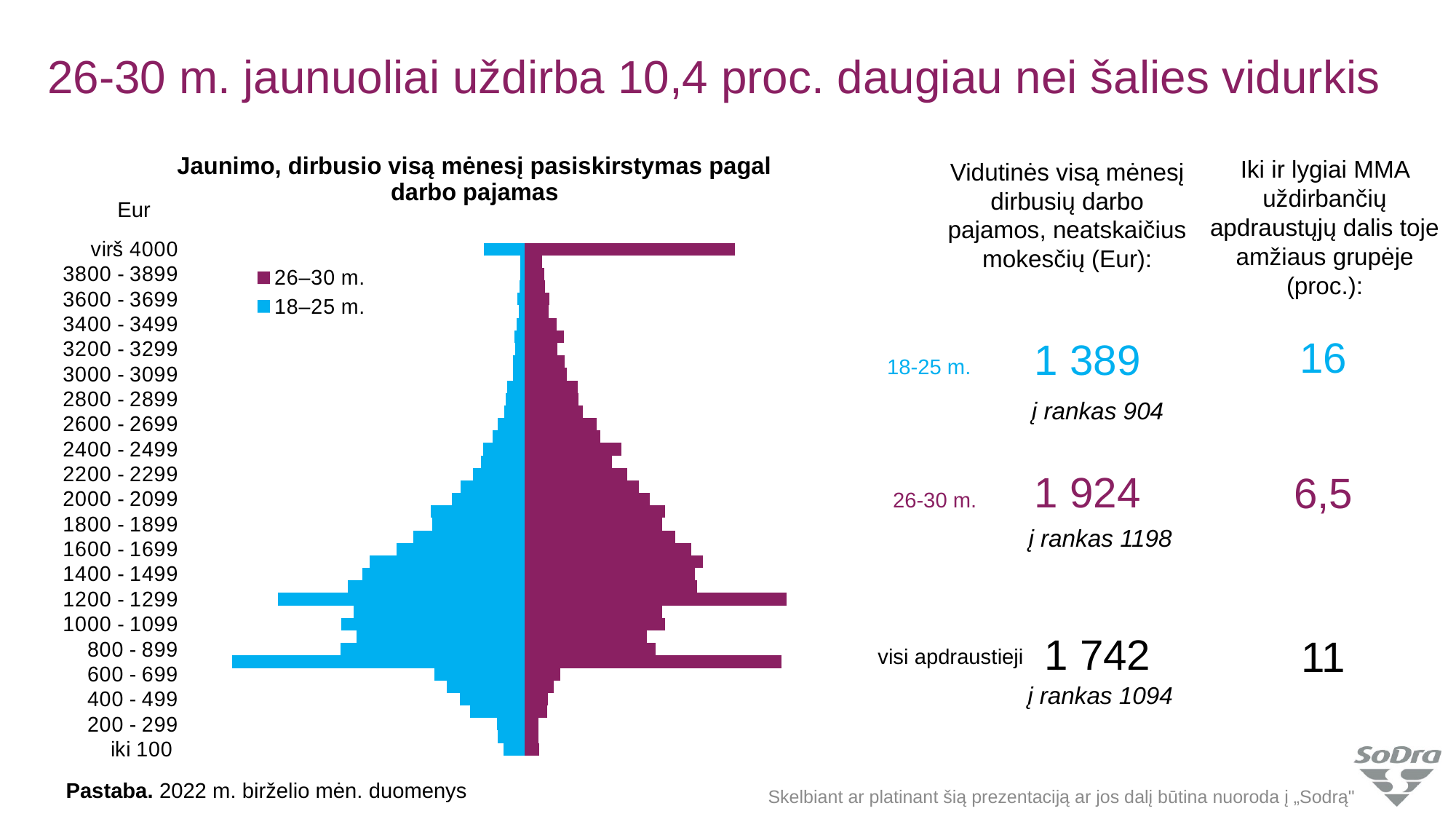
What kind of chart is shown on the slide? bar chart Which age group has the longer bar in the '2000 - 2099' income category? 26–30 m. Which age group has the longer bar in the '600 - 699' income category? 18–25 m. Which age group has the longer bar in the 'virš 4000' income category? 26–30 m. Which colour represents the 18–25 m. series in the chart? blue What is the title of the chart? Jaunimo, dirbusio visą mėnesį pasiskirstymas pagal darbo pajamas How many series does the chart legend list? 2